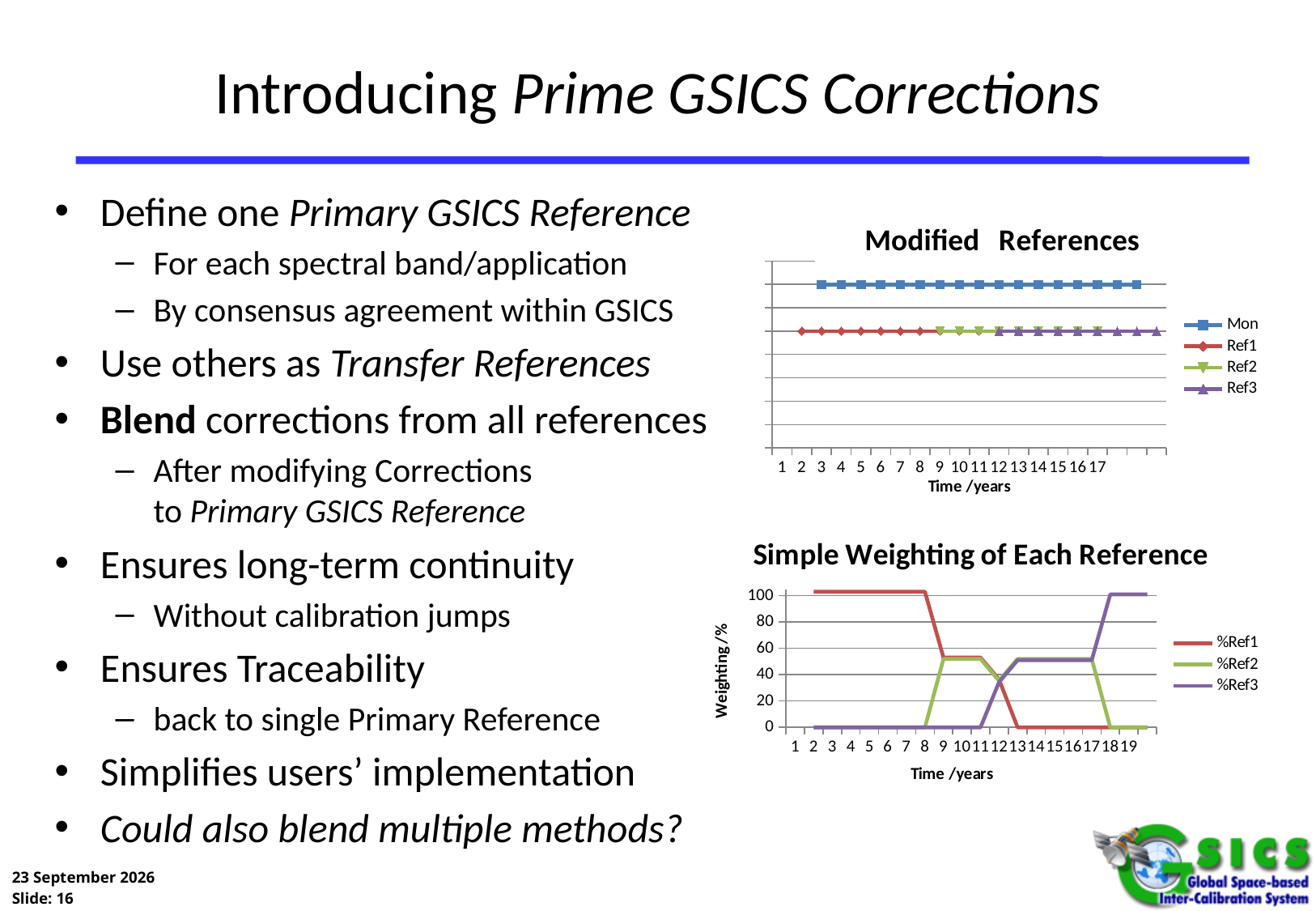
What kind of chart is the 'Simple Weighting of Each Reference' chart? line chart In the 'Simple Weighting of Each Reference' chart, which series has the higher value at year 4, %Ref1 or %Ref3? %Ref1 How many series does the legend of the 'Modified References' chart list? 4 What is the x-axis title of the 'Modified References' chart? Time /years In the 'Simple Weighting of Each Reference' chart, does the %Ref1 series rise or fall over time? fall In the 'Simple Weighting of Each Reference' chart, is the value for %Ref3 at year 15 greater or less than 20? greater In the 'Simple Weighting of Each Reference' chart, what is the weighting of %Ref2 at year 3? 0 In the 'Simple Weighting of Each Reference' chart, is the value for %Ref1 at year 10 greater or less than 80? less How many series does the legend of the 'Simple Weighting of Each Reference' chart list? 3 In the 'Simple Weighting of Each Reference' chart, does the %Ref3 series rise or fall over time? rise